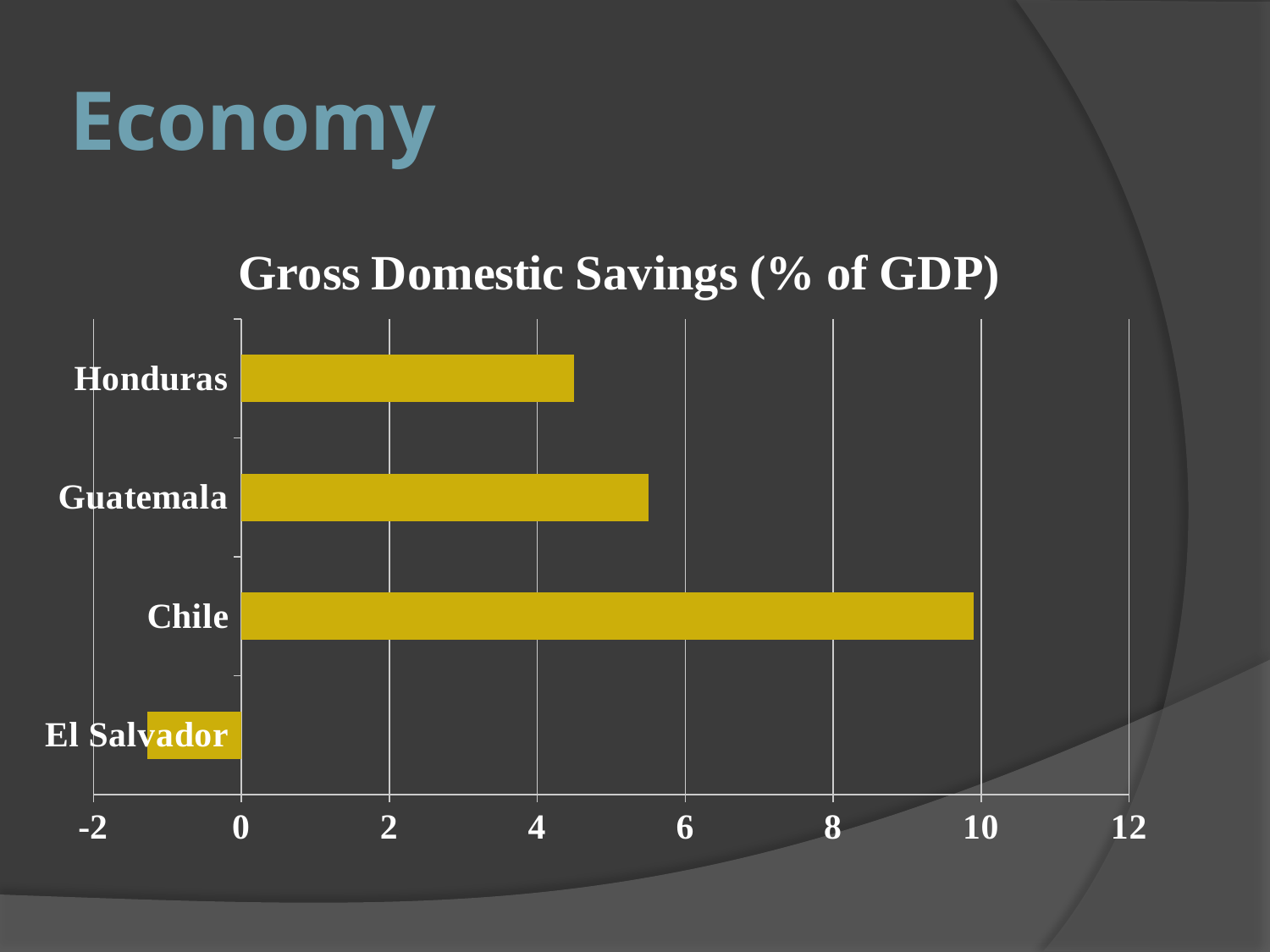
Is the value for Chile greater or less than 8? greater Which country has the lowest gross domestic savings as a percentage of GDP? El Salvador Which country has a higher value, Guatemala or Honduras? Guatemala Is the value for El Salvador greater or less than 0? less What kind of chart is shown on the slide? bar chart Which country has the highest gross domestic savings as a percentage of GDP? Chile Which country has a higher value, Chile or Guatemala? Chile Is the value for Honduras greater or less than 4? greater Which country is the only one with a negative value in the chart? El Salvador What is the title of the chart? Gross Domestic Savings (% of GDP) How many countries are shown in the chart? 4